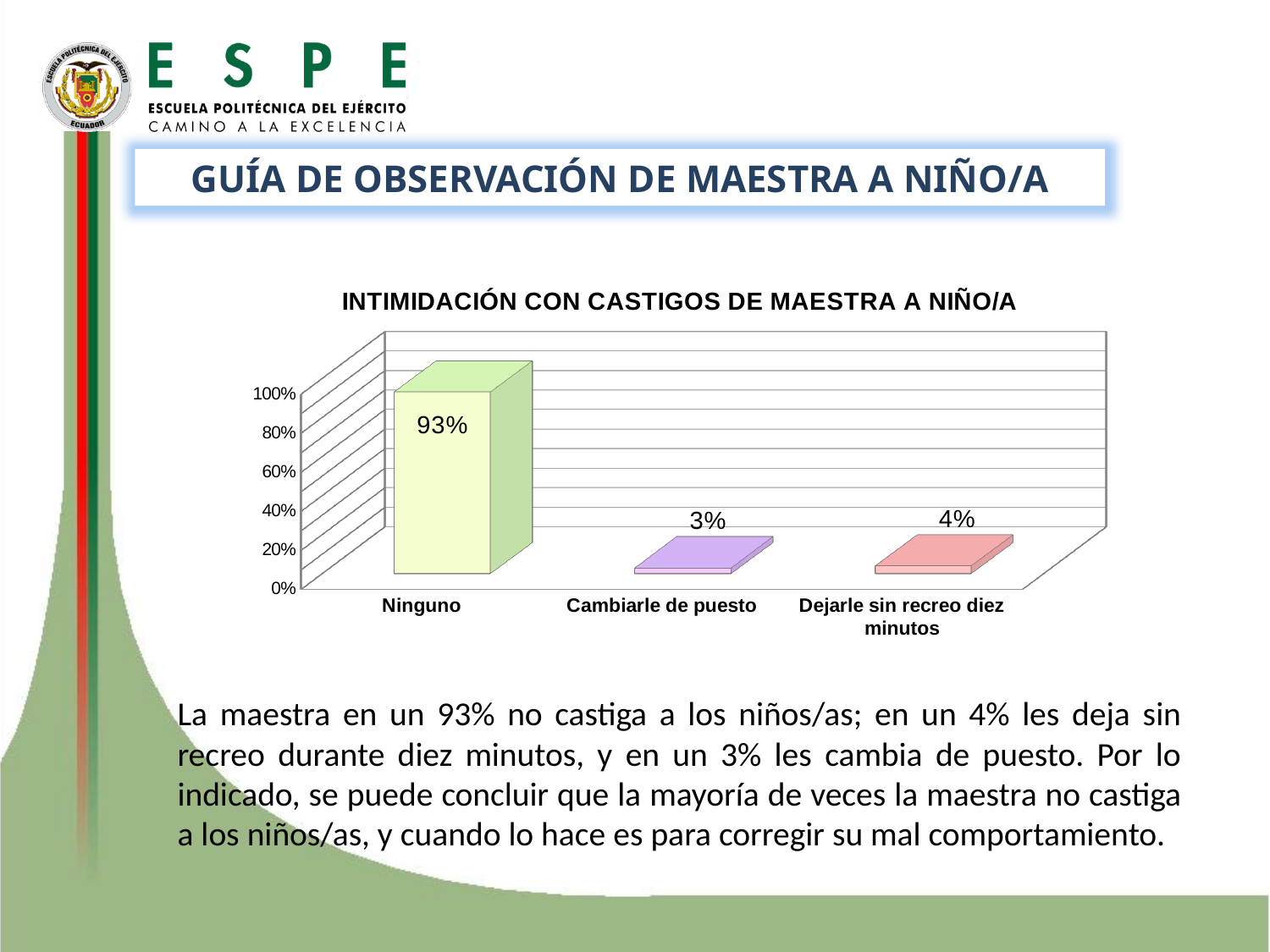
What is the difference between the values for Ninguno and Dejarle sin recreo diez minutos? 89% Which category has the highest value? Ninguno What is the value for Ninguno? 93% Is the value for Ninguno greater or less than 80%? greater What is the value for Dejarle sin recreo diez minutos? 4% Which category has the lowest value? Cambiarle de puesto What is the value for Cambiarle de puesto? 3% How many categories are shown on the x axis? 3 What is the difference between the values for Dejarle sin recreo diez minutos and Cambiarle de puesto? 1% Which is larger, the value for Ninguno or the value for Cambiarle de puesto? Ninguno What is the title of the chart? INTIMIDACIÓN CON CASTIGOS DE MAESTRA A NIÑO/A What kind of chart is shown? bar chart